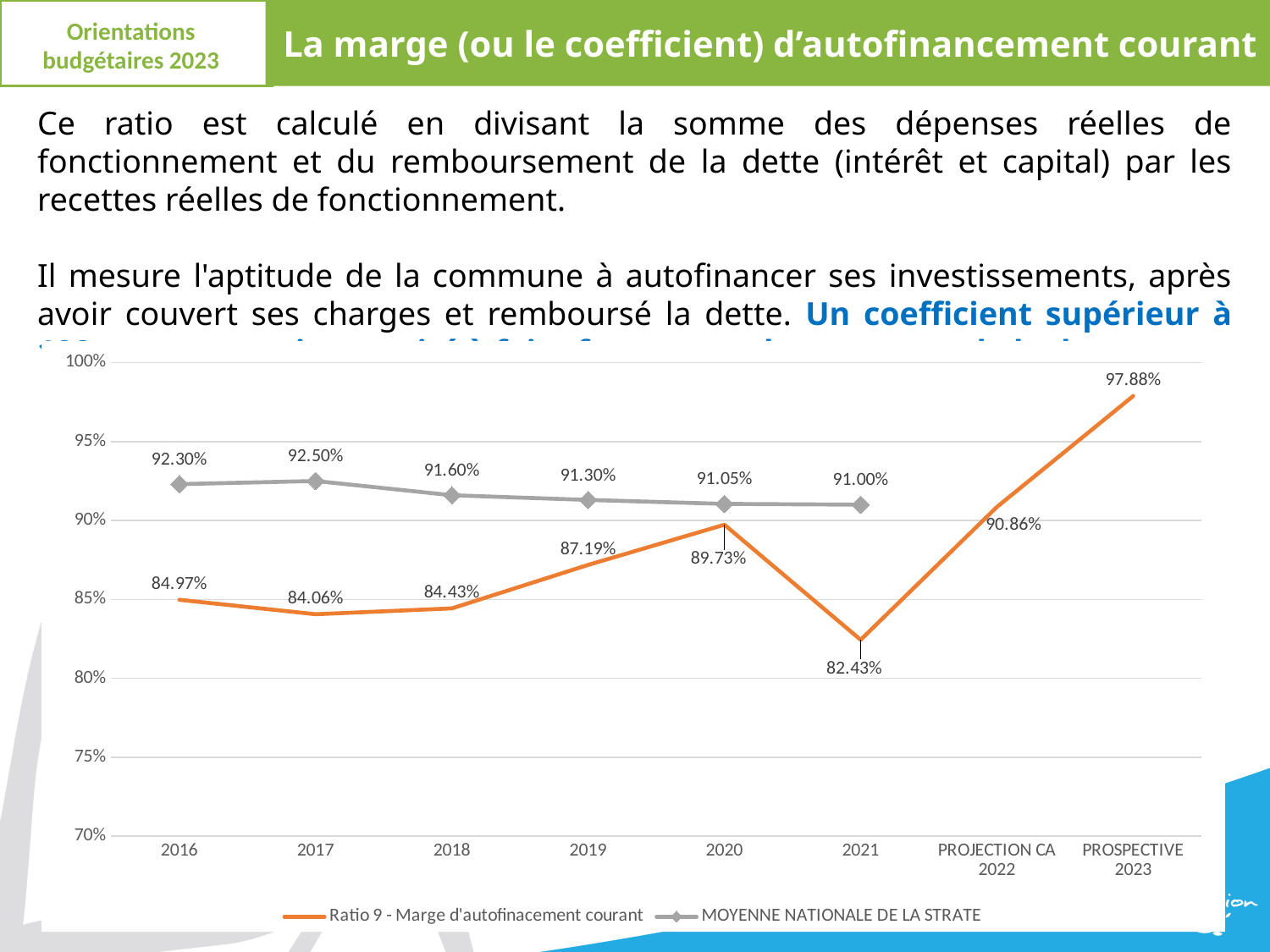
What is the value of Ratio 9 - Marge d'autofinacement courant for PROSPECTIVE 2023? 97.88% What is the value of Ratio 9 - Marge d'autofinacement courant in 2021? 82.43% How many series does the legend list? 2 In which category is the Ratio 9 - Marge d'autofinacement courant series at its highest? PROSPECTIVE 2023 In which year is the MOYENNE NATIONALE DE LA STRATE series at its highest? 2017 What kind of chart is shown on the slide? Line chart What is the difference between MOYENNE NATIONALE DE LA STRATE and Ratio 9 - Marge d'autofinacement courant in 2016? 7.33% Does the MOYENNE NATIONALE DE LA STRATE series rise or fall from 2017 to 2021? Fall Which series has the larger value in 2020, Ratio 9 - Marge d'autofinacement courant or MOYENNE NATIONALE DE LA STRATE? MOYENNE NATIONALE DE LA STRATE What is the value of MOYENNE NATIONALE DE LA STRATE in 2018? 91.60% How many categories are shown on the x axis? 8 In which year is the Ratio 9 - Marge d'autofinacement courant series at its lowest? 2021